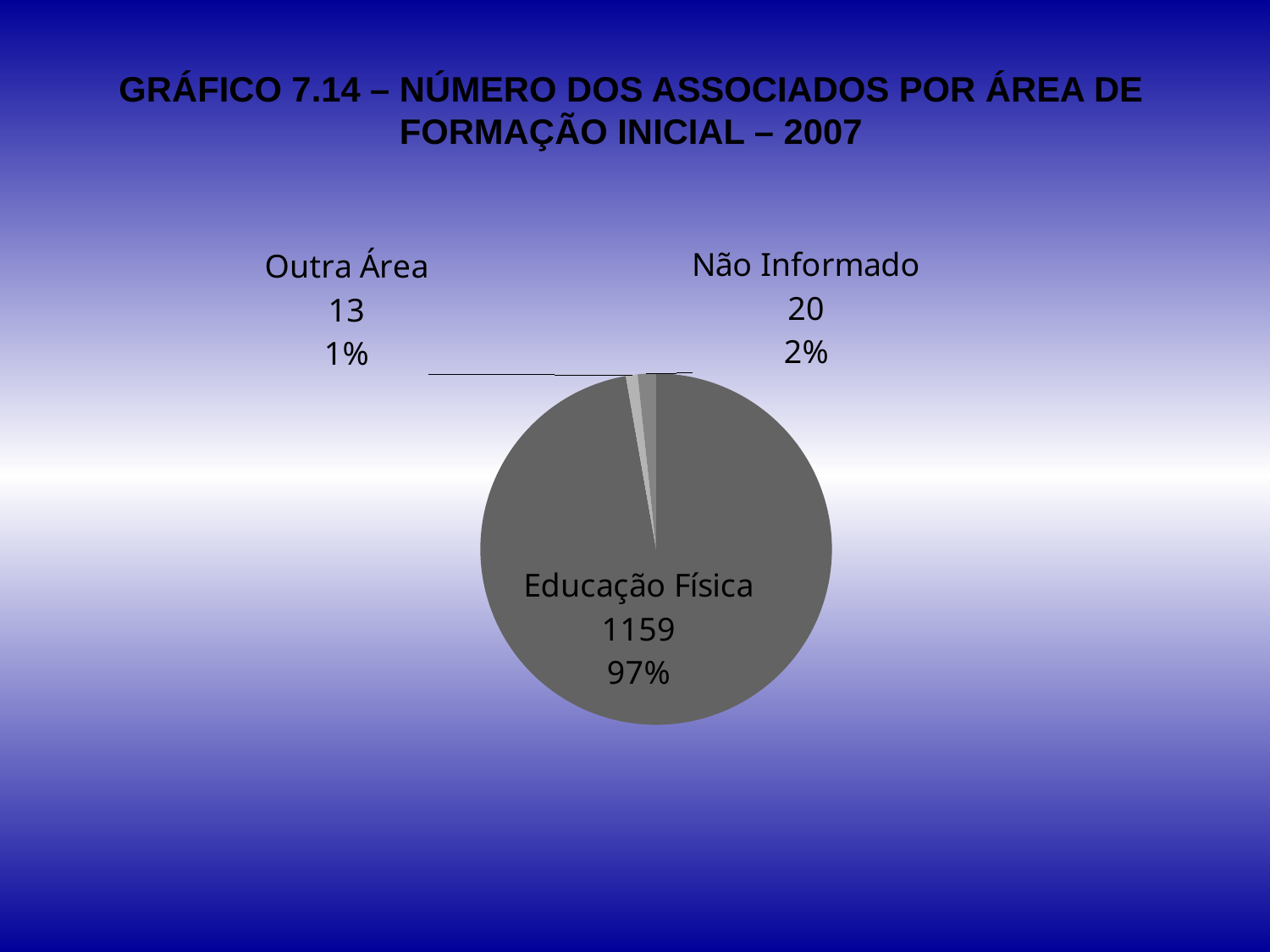
How many categories are shown in the pie chart? 3 Which category has the largest slice of the pie? Educação Física How many associates have Educação Física as their initial training area? 1159 What share of the pie does Não Informado represent? 2% How many associates are in the Outra Área category? 13 Which category has more associates, Não Informado or Outra Área? Não Informado What share of the pie does Outra Área represent? 1% Which category has the smallest slice of the pie? Outra Área How many associates are in the Não Informado category? 20 What share of the pie does Educação Física represent? 97% What kind of chart is shown on the slide? pie chart What is the difference between the number of associates in Não Informado and Outra Área? 7